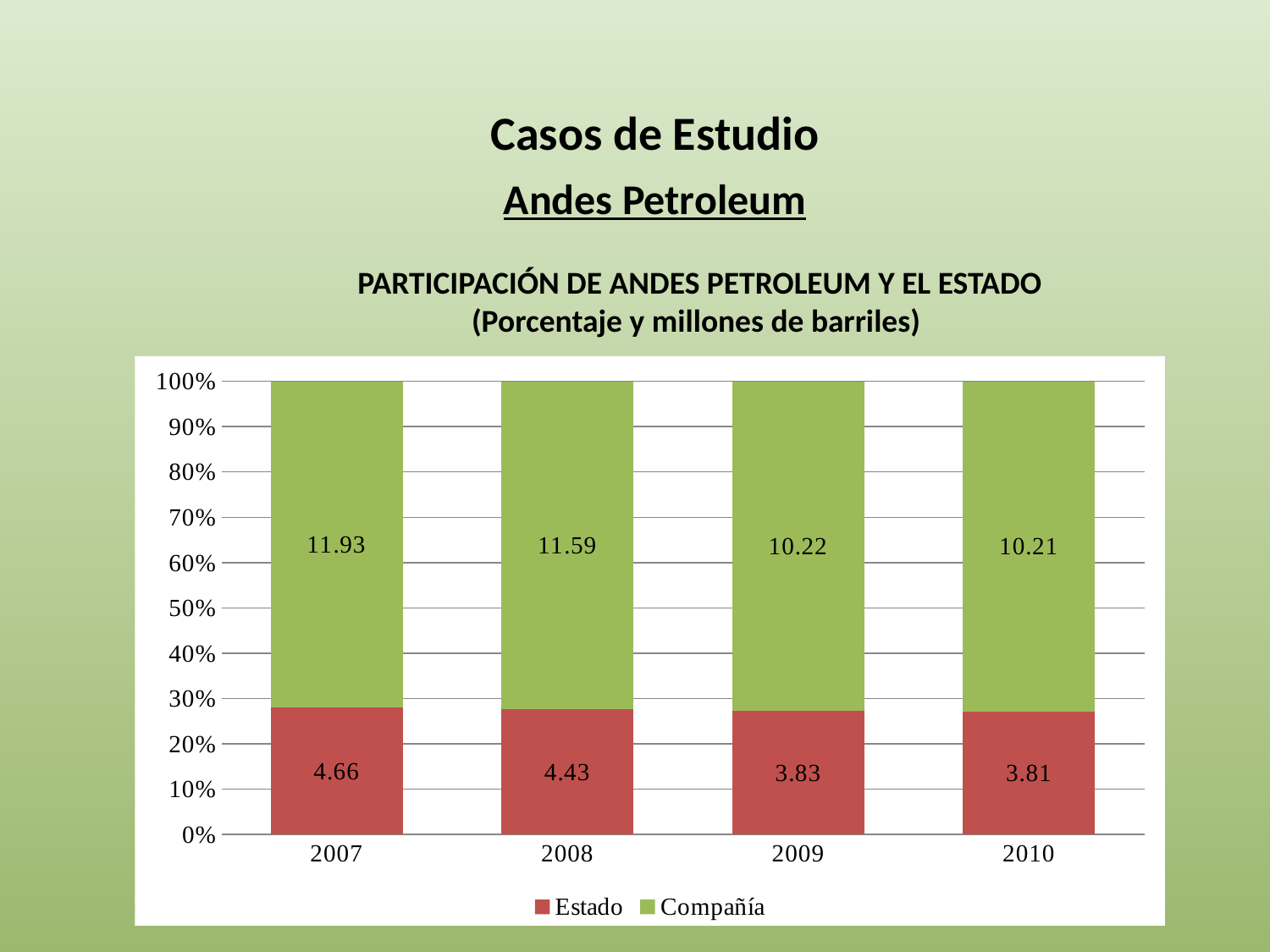
What is the value for Compañía in 2008? 11.59 What is the value for Estado in 2007? 4.66 What is the difference between the Compañía and Estado values in 2007? 7.27 What is the value for Compañía in 2009? 10.22 In which year is the Compañía value highest? 2007 How many series does the legend list? 2 What is the total of the Estado and Compañía values in 2010? 14.02 How many years are shown on the x axis? 4 In which year is the Estado value lowest? 2010 Do the Estado values rise or fall from 2007 to 2010? fall What is the value for Estado in 2010? 3.81 Which is larger, the Estado value in 2008 or the Estado value in 2009? 2008